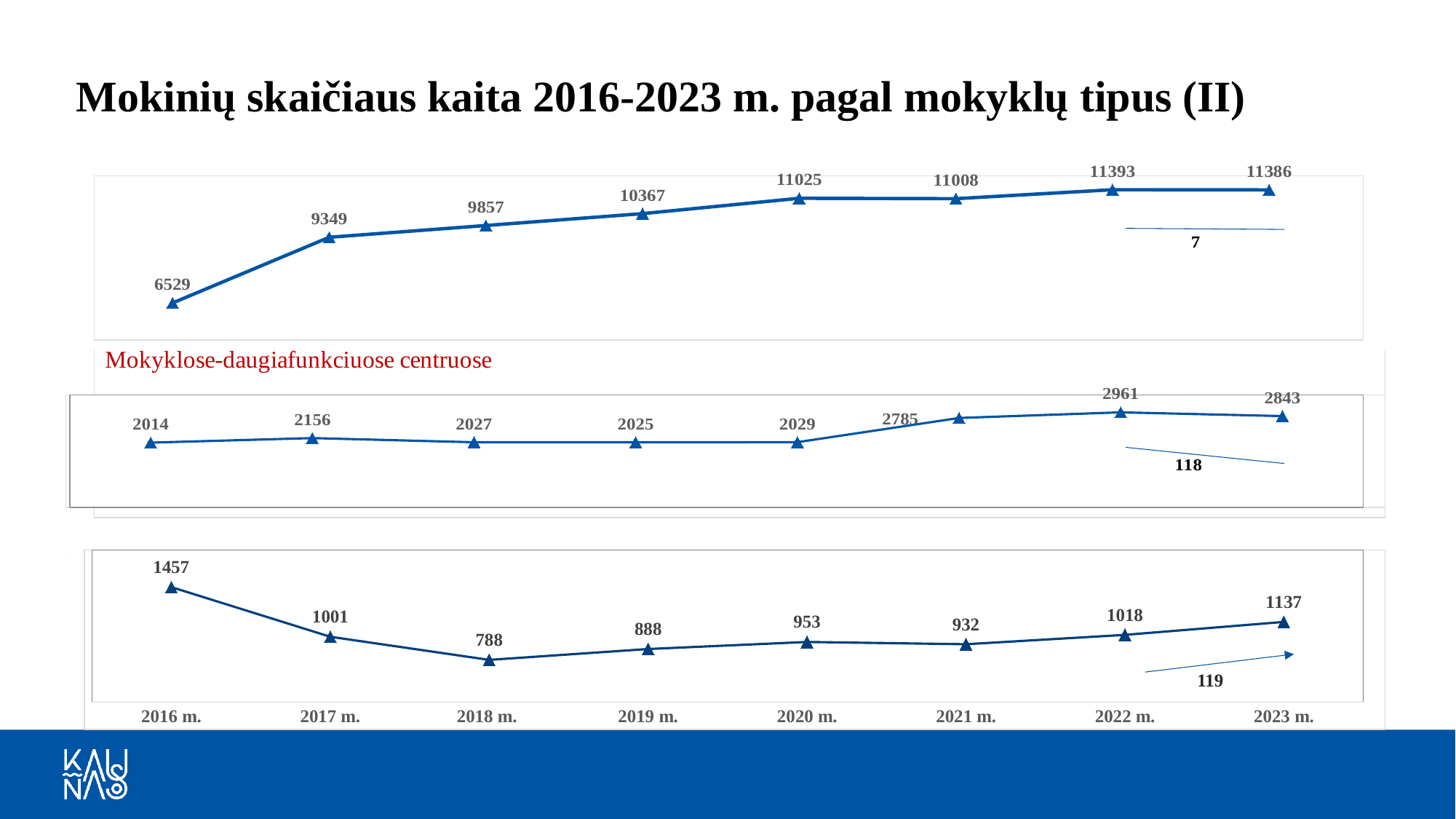
In the top chart, do the values generally rise or fall from 2016 m. to 2023 m.? rise How many data points does the bottom chart plot? 8 In the middle chart, what is the value for 2021 m.? 2785 In the top chart, what is the difference between the 2017 m. value and the 2016 m. value? 2820 In the middle chart, what is the difference between the 2022 m. value and the 2023 m. value? 118 In the bottom chart, which year has the highest value? 2016 m. In the top chart, which year has the highest value? 2022 m. In the top chart, what is the value for 2016 m.? 6529 In the middle chart, which year has the lowest value? 2016 m. What type of chart is the top chart? line chart In the bottom chart, what is the value for 2018 m.? 788 In the bottom chart, is the value for 2023 m. larger or smaller than the value for 2022 m.? larger